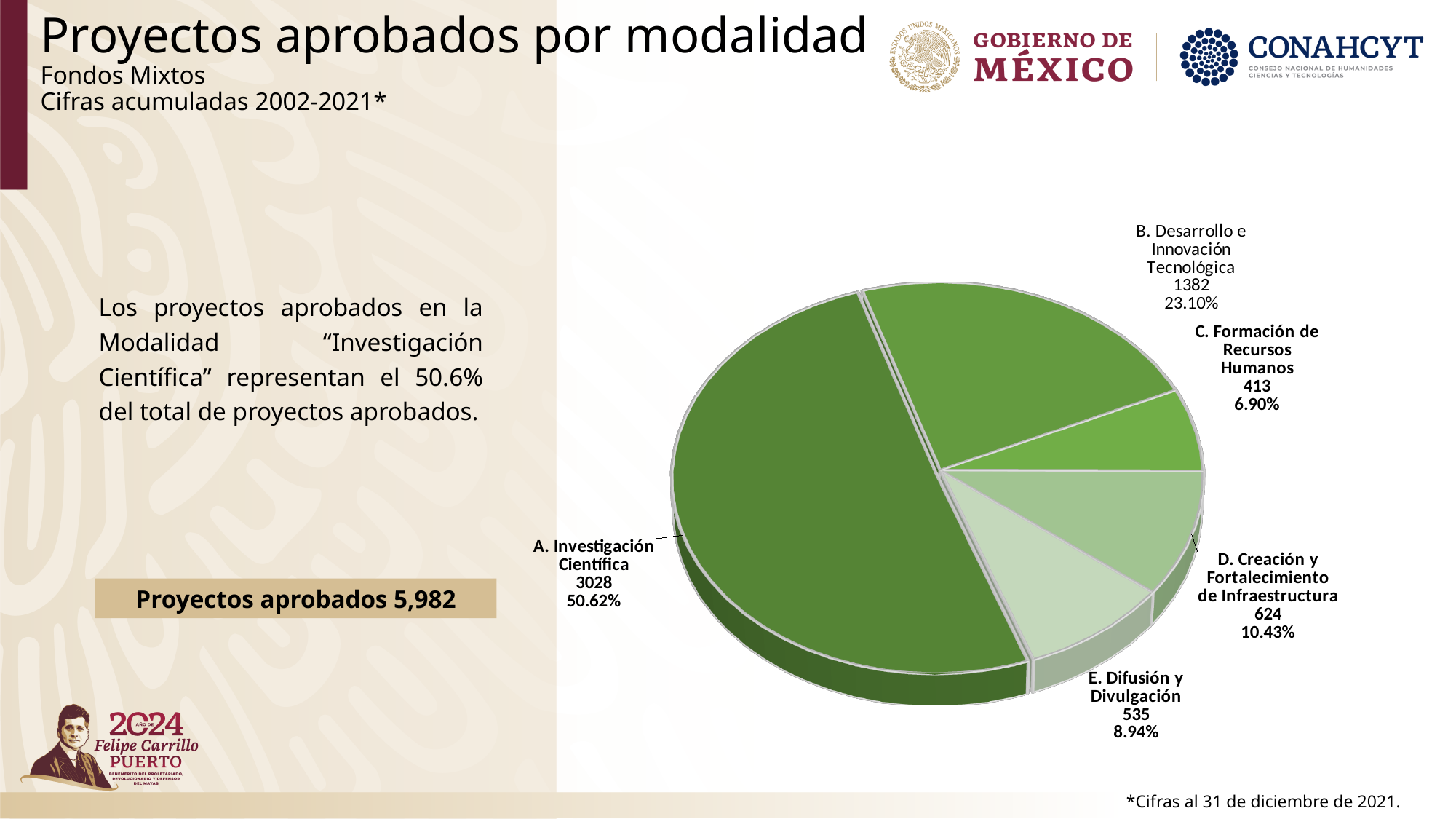
What percentage share does B. Desarrollo e Innovación Tecnológica have in the pie chart? 23.10% What is the total number of approved projects shown on the slide? 5,982 What is the value shown for C. Formación de Recursos Humanos? 413 Which has more approved projects, D. Creación y Fortalecimiento de Infraestructura or E. Difusión y Divulgación? D. Creación y Fortalecimiento de Infraestructura What percentage is shown for D. Creación y Fortalecimiento de Infraestructura? 10.43% Which modality has the smallest slice of the pie chart? C. Formación de Recursos Humanos What kind of chart is shown on the slide? pie chart Which modality has the largest slice of the pie chart? A. Investigación Científica What is the title of the slide containing the pie chart? Proyectos aprobados por modalidad How many approved projects are shown for A. Investigación Científica? 3028 How many slices does the pie chart have? 5 What is the difference in number of projects between B. Desarrollo e Innovación Tecnológica and E. Difusión y Divulgación? 847